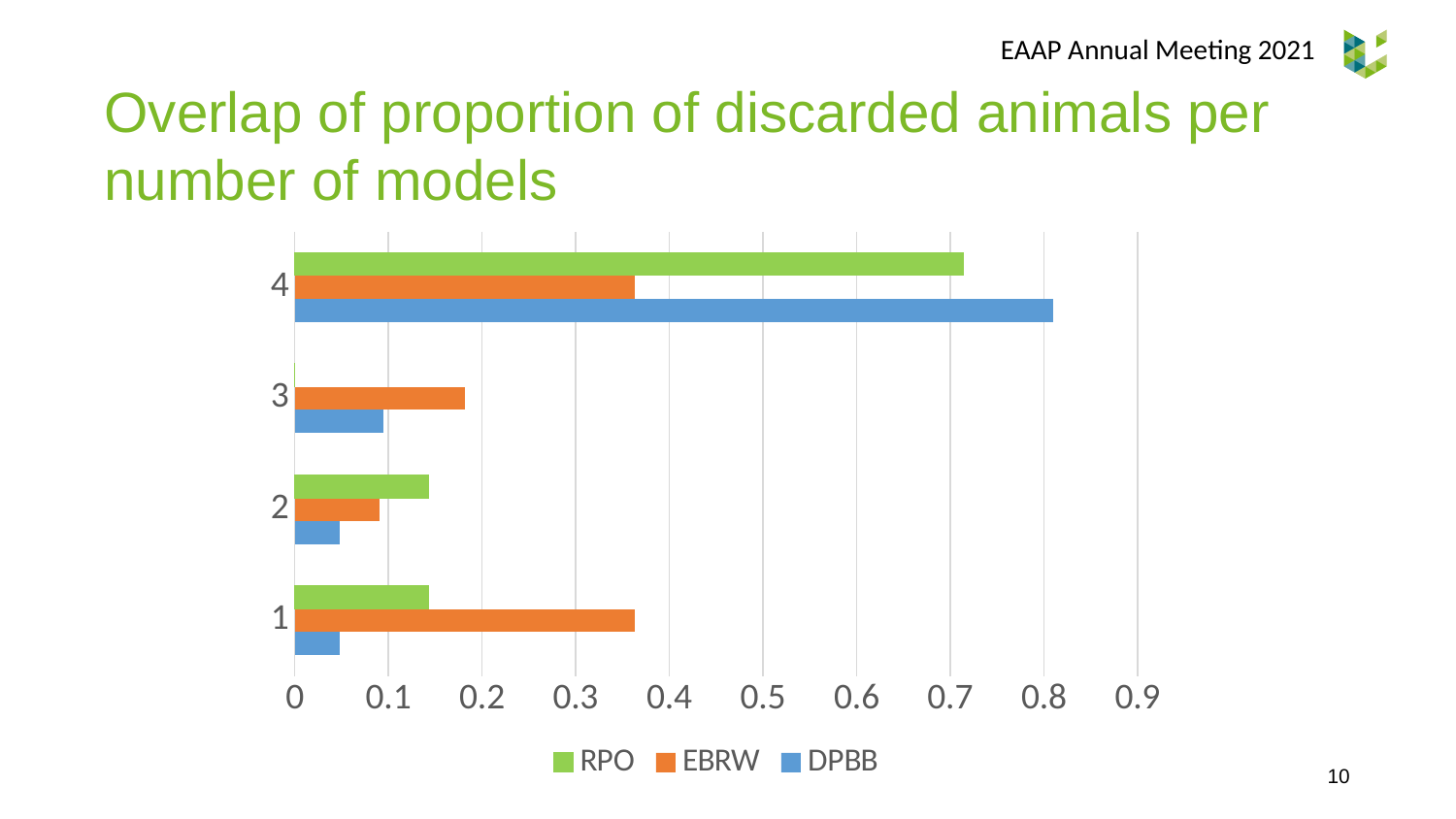
For category 1, which series has the larger value, EBRW or DPBB? EBRW For category 4, which series has the larger value, RPO or EBRW? RPO Is the RPO value for category 4 greater or less than 0.7? greater Is the EBRW value for category 3 greater or less than 0.2? less Which series is shown in orange in the legend? EBRW Which category has the highest RPO value? 4 Is the DPBB value for category 4 greater or less than 0.8? greater How many categories (number of models) are shown on the vertical axis? 4 What kind of chart is shown on the slide? bar chart How many series does the legend list? 3 Which category has the highest DPBB value? 4 What is the title of the slide containing the chart? Overlap of proportion of discarded animals per number of models